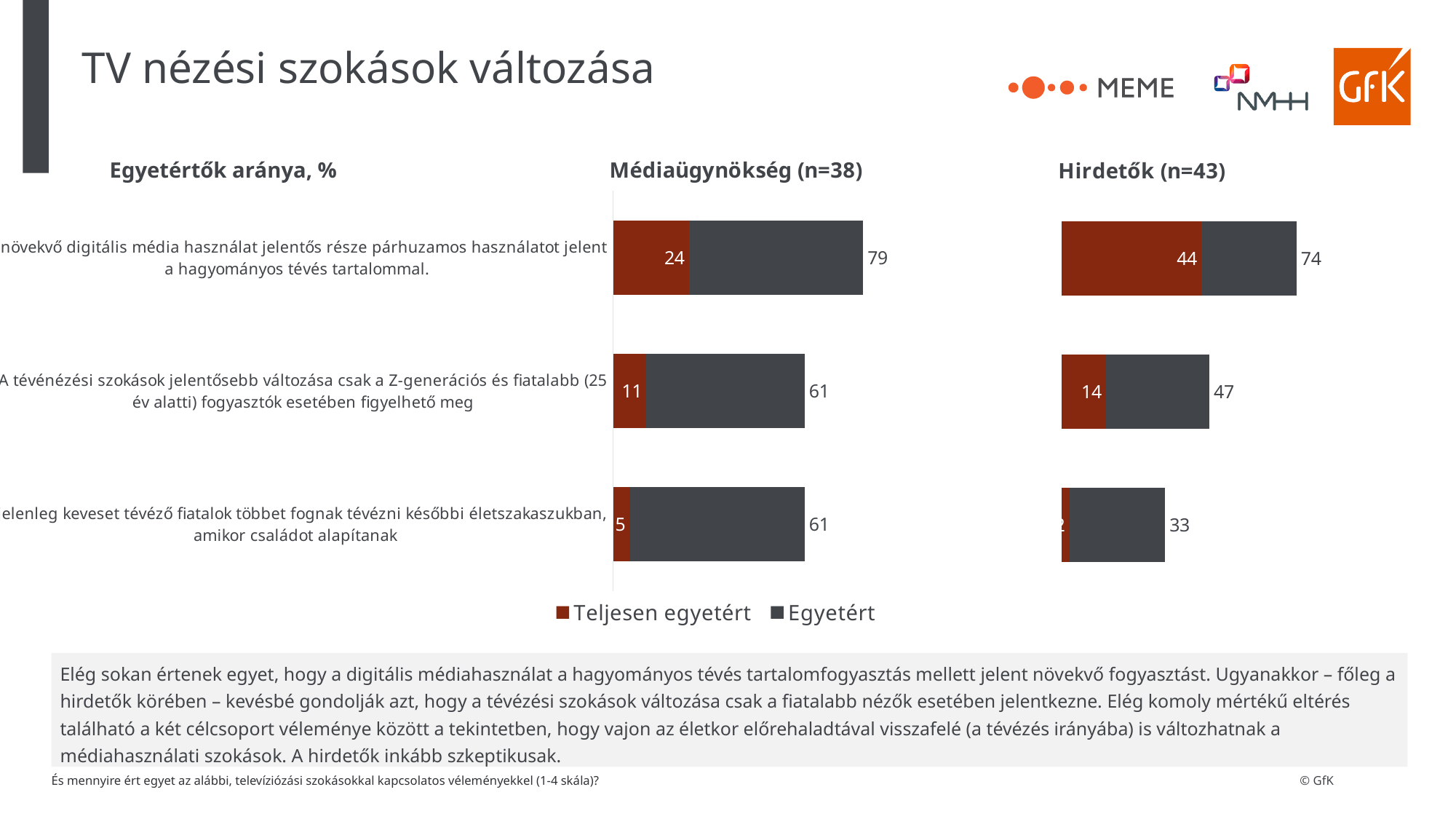
In the Médiaügynökség (n=38) chart, which statement has the highest total value? The top statement, that growing digital media use largely means parallel use with traditional TV content What kind of chart is the Hirdetők (n=43) chart? Stacked horizontal bar chart In the Médiaügynökség (n=38) chart, what is the 'Teljesen egyetért' value for the statement 'A tévénézési szokások jelentősebb változása csak a Z-generációs és fiatalabb (25 év alatti) fogyasztók esetében figyelhető meg'? 11 In the Hirdetők (n=43) chart, what is the difference between the total for the top statement (74) and the total for the middle statement (47)? 27 In the Hirdetők (n=43) chart, what total value is labelled at the end of the bar for the top statement about digital media use being parallel use with traditional TV content? 74 In the Hirdetők (n=43) chart, which statement has the lowest total value? The bottom statement, that young people who currently watch little TV will watch more later when they start a family In the Médiaügynökség (n=38) chart, what is the 'Teljesen egyetért' value for the top statement about growing digital media use being parallel use with traditional TV content? 24 In the Hirdetők (n=43) chart, what total value is labelled at the end of the bar for the bottom statement about young people who currently watch little TV watching more later when they start a family? 33 How many series does the legend below the charts list? 2 How many statements (categories) are plotted in the Médiaügynökség (n=38) chart? 3 In the Hirdetők (n=43) chart, what total value is labelled at the end of the bar for the statement about TV viewing changes being observable only among Generation Z and younger consumers? 47 For the top statement, is the 'Teljesen egyetért' value larger in the Médiaügynökség (n=38) chart or in the Hirdetők (n=43) chart? Hirdetők (n=43)